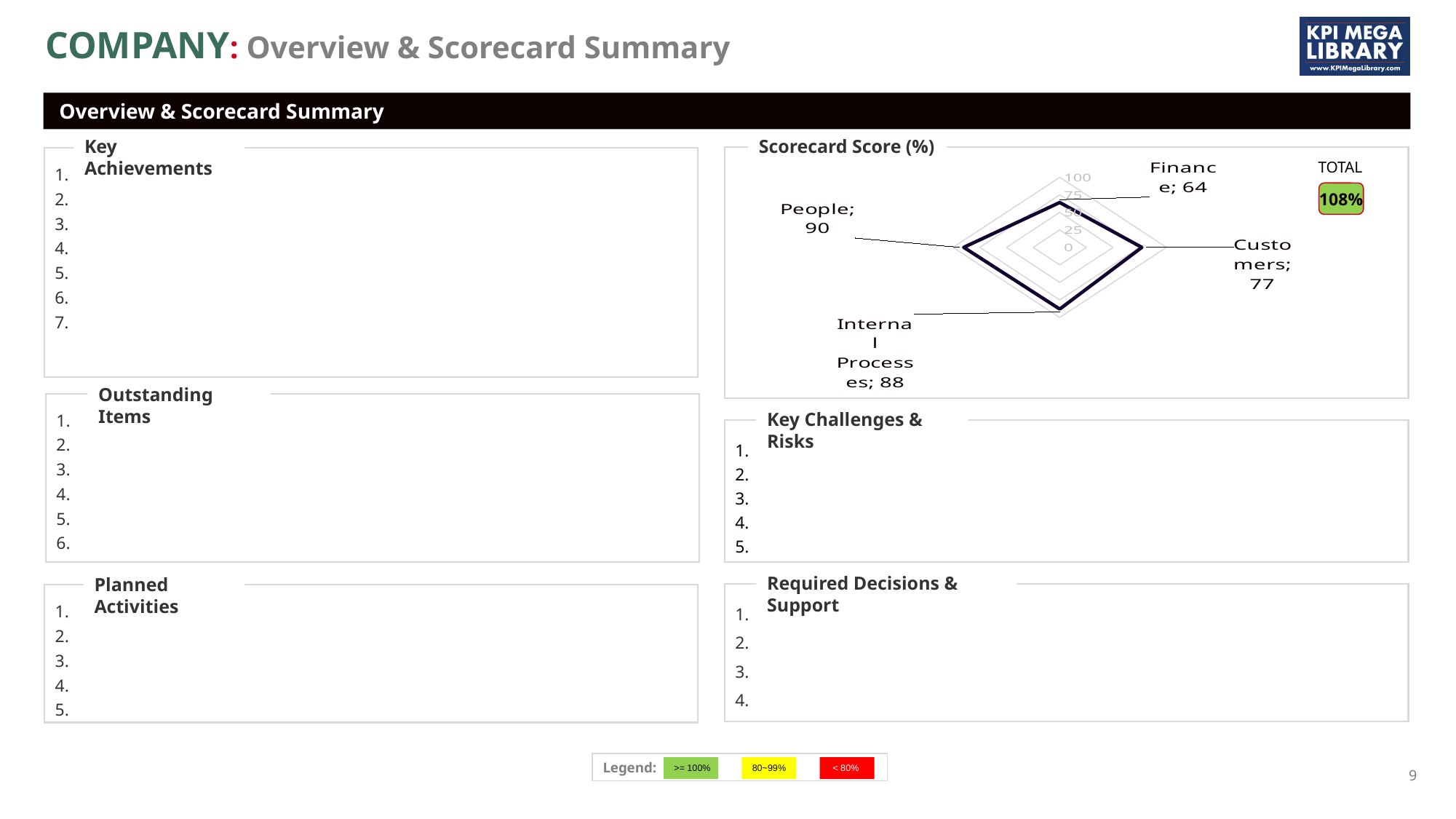
What kind of chart is the Scorecard Score (%) chart? Radar chart What is the value for People in the Scorecard Score (%) chart? 90 How many categories are plotted in the Scorecard Score (%) chart? 4 What TOTAL value is shown next to the Scorecard Score (%) chart? 108% What is the value for Customers in the Scorecard Score (%) chart? 77 What is the highest tick value shown on the axis of the Scorecard Score (%) chart? 100 In the Scorecard Score (%) chart, which is larger: Customers or Internal Processes? Internal Processes What is the value for Finance in the Scorecard Score (%) chart? 64 What is the value for Internal Processes in the Scorecard Score (%) chart? 88 Which category has the highest value in the Scorecard Score (%) chart? People What is the difference between the People and Finance values in the Scorecard Score (%) chart? 26 Which category has the lowest value in the Scorecard Score (%) chart? Finance